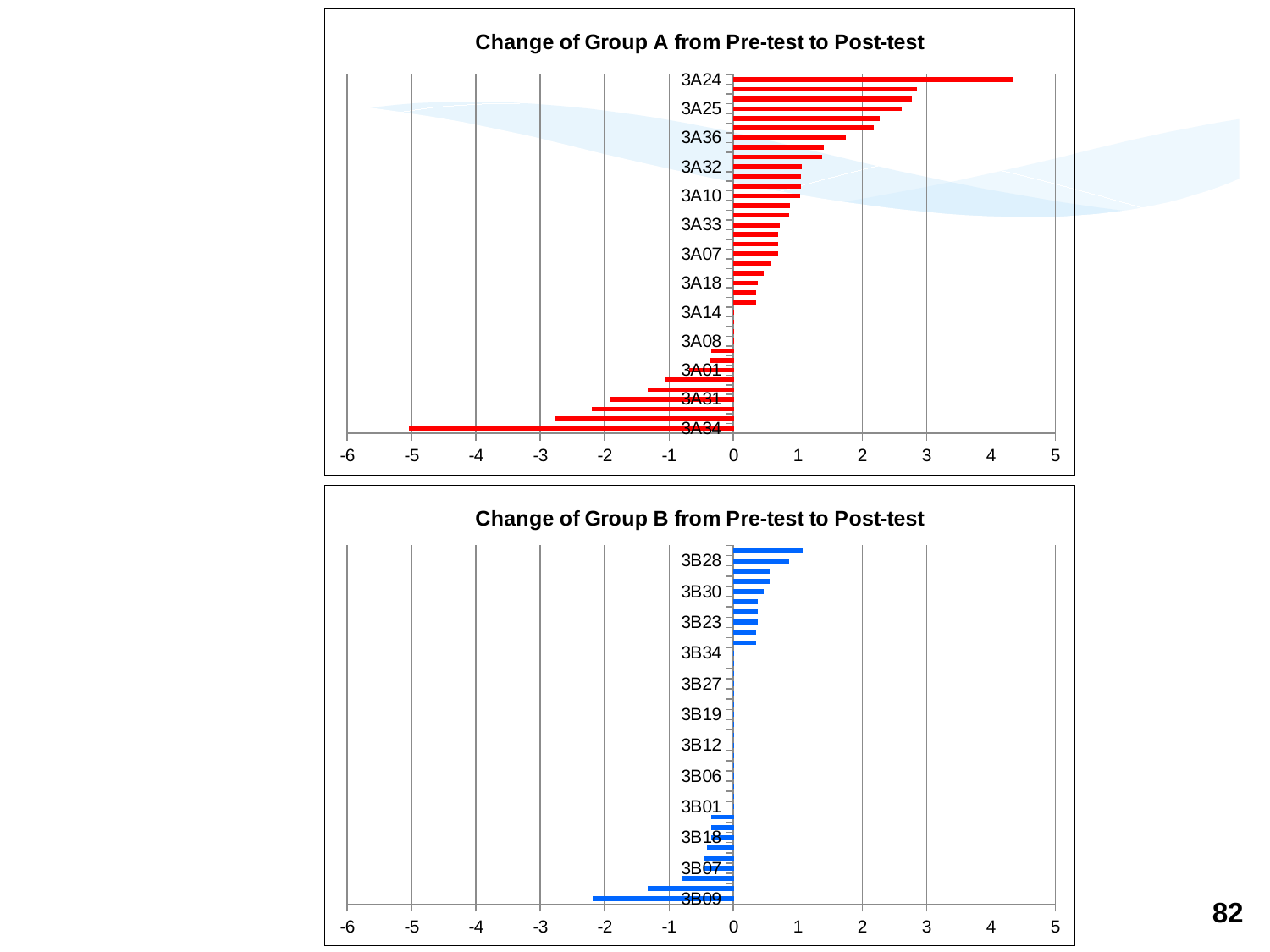
In the 'Change of Group A from Pre-test to Post-test' chart, is the value for 3A34 greater or less than -4? less In the 'Change of Group B from Pre-test to Post-test' chart, which labeled student has the lowest value? 3B09 In the 'Change of Group B from Pre-test to Post-test' chart, which is larger, the value for 3B34 or the value for 3B18? 3B34 In the 'Change of Group A from Pre-test to Post-test' chart, which is larger, the value for 3A36 or the value for 3A01? 3A36 In the 'Change of Group A from Pre-test to Post-test' chart, is the value for 3A25 greater or less than 2? greater What colour are the bars in the 'Change of Group B from Pre-test to Post-test' chart? blue In the 'Change of Group B from Pre-test to Post-test' chart, is the value for 3B28 greater or less than 1? less What type of chart is 'Change of Group A from Pre-test to Post-test'? bar chart In the 'Change of Group A from Pre-test to Post-test' chart, which labeled student has the highest value? 3A24 In the 'Change of Group A from Pre-test to Post-test' chart, which labeled student has the lowest value? 3A34